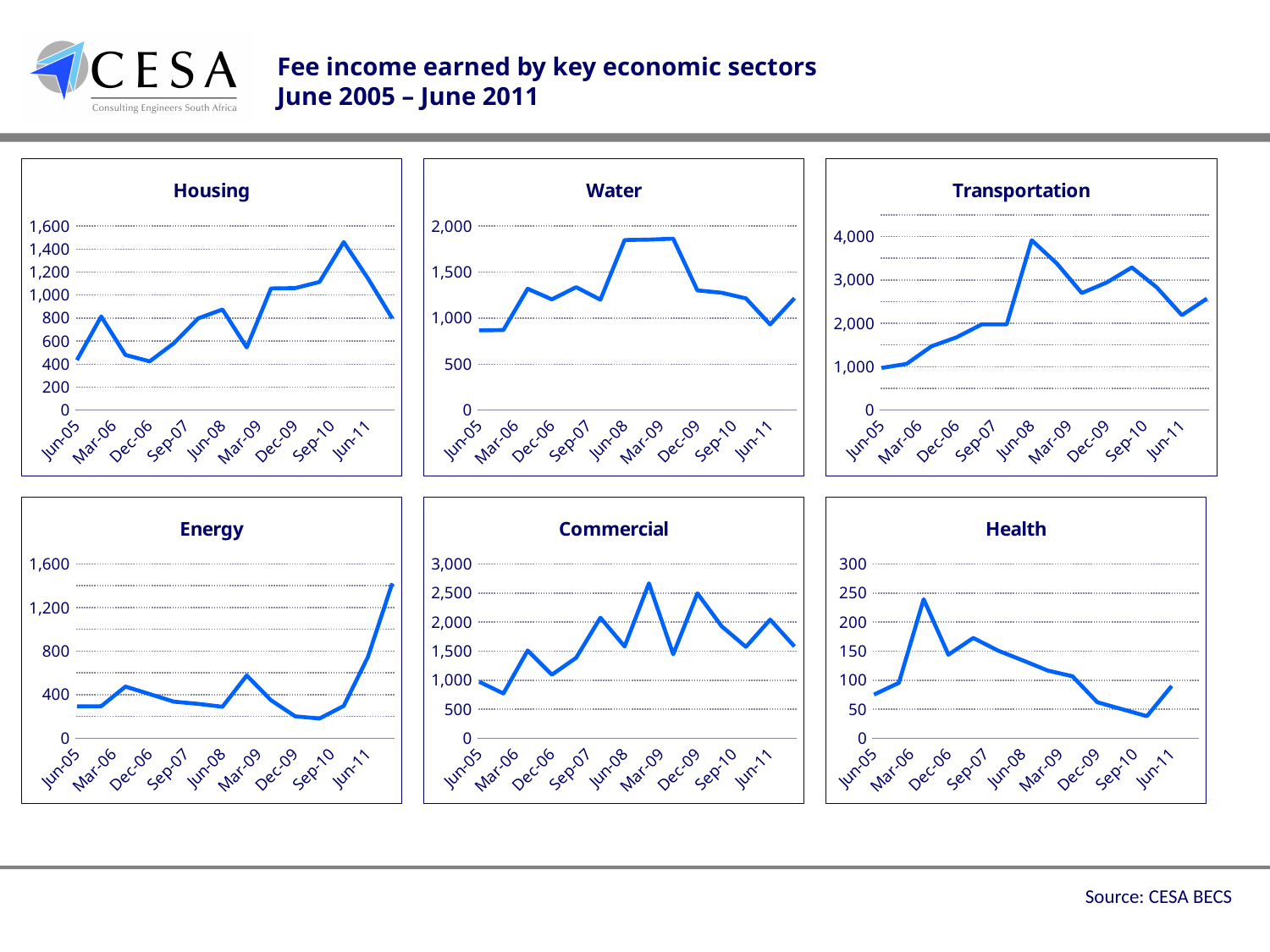
What kind of chart is the Housing chart? line chart In the Housing chart, which is larger, the value for Jun-05 or the value for Sep-10? Sep-10 In the Transportation chart, is the peak value at Jun-08 greater or less than 3,000? greater How many charts are shown on the slide? 6 In the Health chart, do values rise or fall from Mar-06 to Sep-10? fall What is the title of the chart in the bottom-right position? Health In the Transportation chart, at which period is the value highest? Jun-08 In the Water chart, is the value for Jun-05 greater or less than 1,000? less